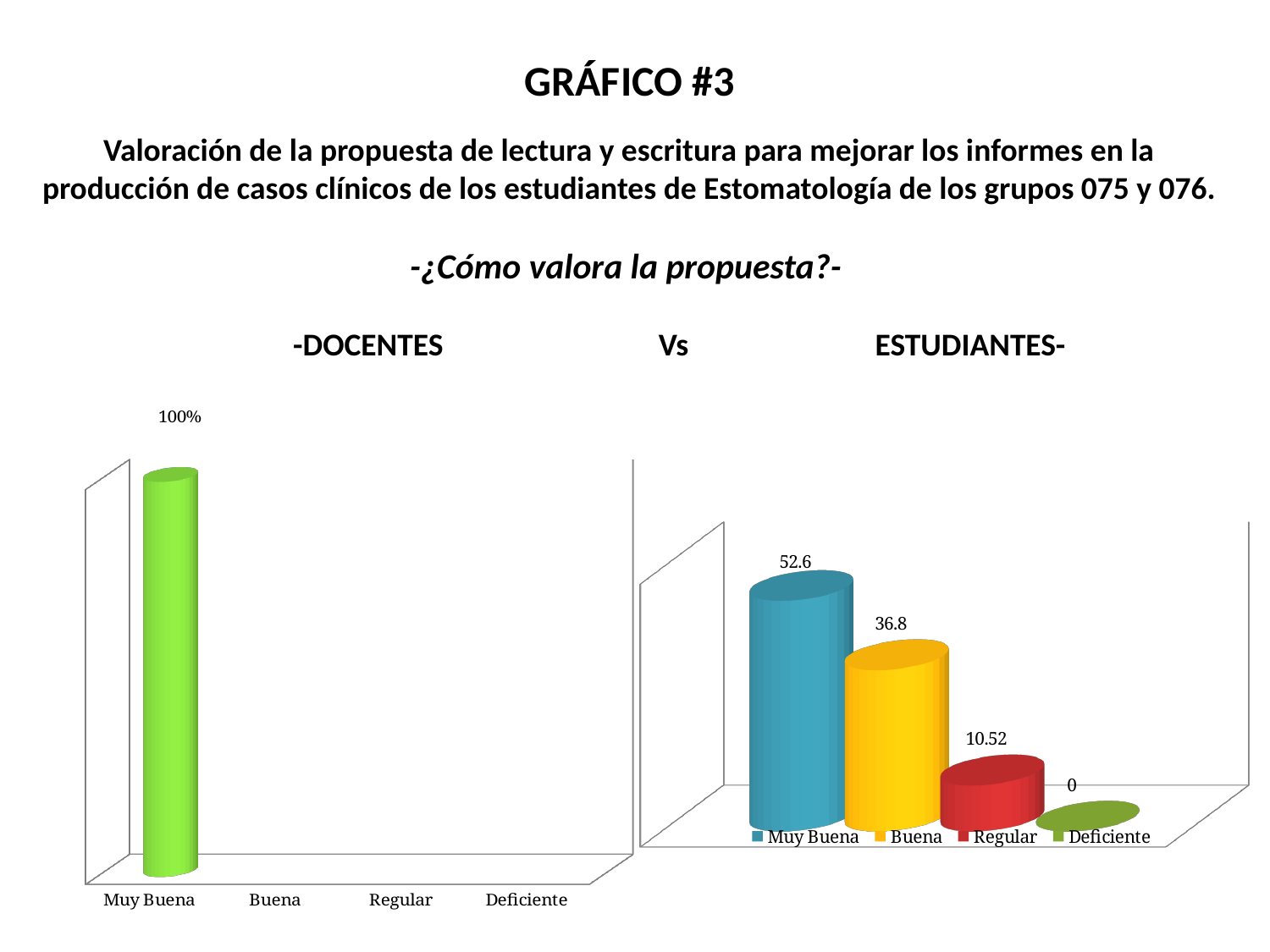
In the DOCENTES chart on the left, what is the value for Muy Buena? 100% In the ESTUDIANTES chart on the right, what is the value for Buena? 36.8 How many entries does the legend of the ESTUDIANTES chart on the right list? 4 What kind of chart is the DOCENTES chart on the left? Bar chart In the ESTUDIANTES chart on the right, which category has the lowest value? Deficiente How many categories are shown on the x axis of the DOCENTES chart on the left? 4 In the ESTUDIANTES chart on the right, what is the value for Muy Buena? 52.6 In the ESTUDIANTES chart on the right, what is the value for Regular? 10.52 In the ESTUDIANTES chart on the right, which is larger, the value for Buena or the value for Regular? Buena In the ESTUDIANTES chart on the right, what is the difference between the values for Muy Buena and Buena? 15.8 In the ESTUDIANTES chart on the right, which category has the highest value? Muy Buena In the ESTUDIANTES chart on the right, what is the value for Deficiente? 0